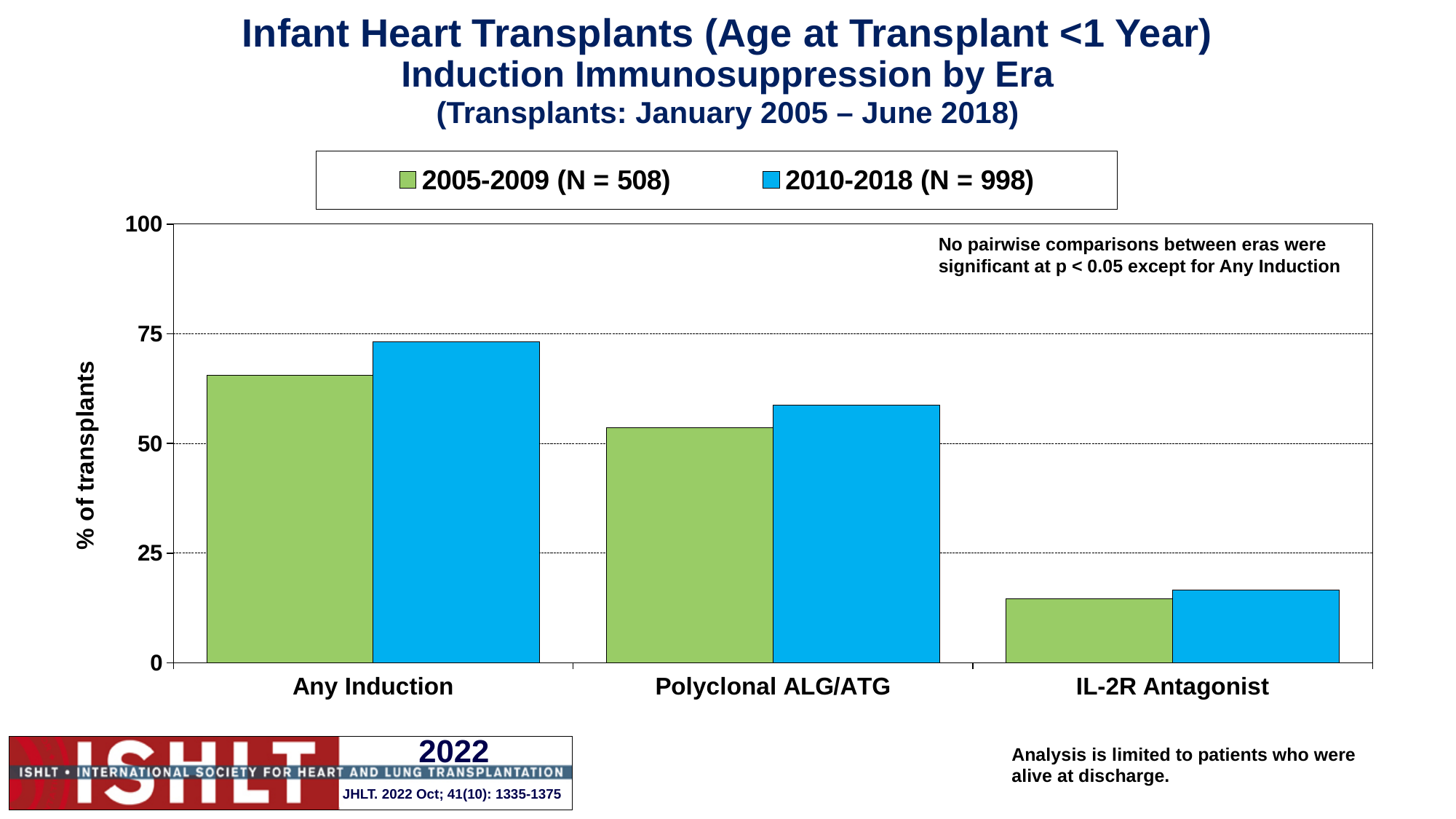
Is the value for IL-2R Antagonist in 2005-2009 greater or less than 25? less Is the value for Polyclonal ALG/ATG in 2010-2018 greater or less than 50? greater How many series does the legend list? 2 What is the N shown in the legend for the 2005-2009 era? 508 How many categories are shown on the x axis? 3 Which category has the highest values for both eras? Any Induction For Polyclonal ALG/ATG, which era has the larger percentage of transplants? 2010-2018 (N = 998) Is the value for Any Induction in 2005-2009 greater or less than 50? greater What kind of chart is shown on the slide? bar chart Which category has the lowest values for both eras? IL-2R Antagonist What is the label of the y axis? % of transplants For Any Induction, which era has the larger percentage of transplants? 2010-2018 (N = 998)